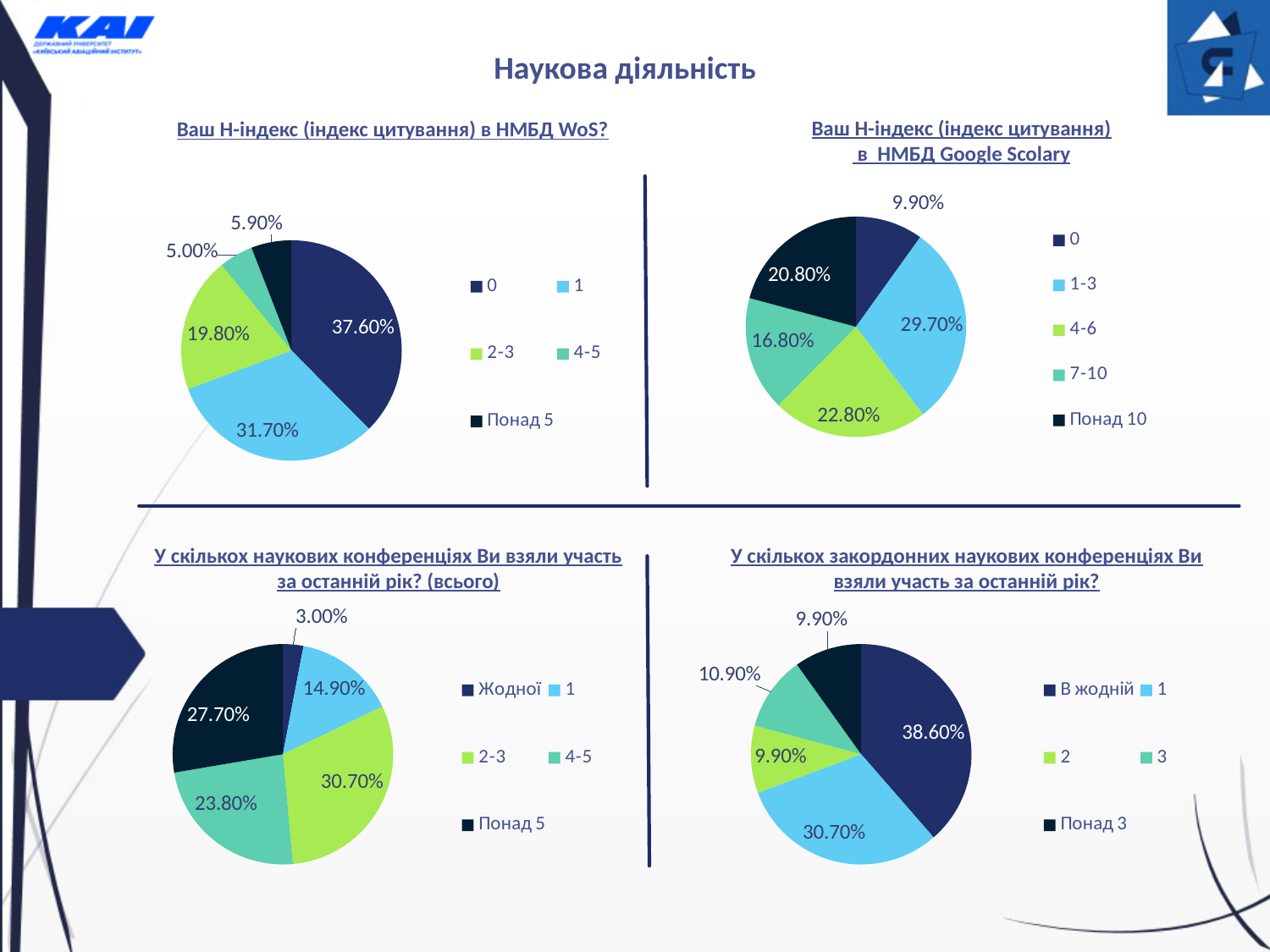
In the chart 'Ваш Н-індекс (індекс цитування) в НМБД Google Scolary', how many categories does the legend list? 5 In the chart 'Ваш Н-індекс (індекс цитування) в НМБД WoS?', what is the difference between the shares for '0' and '1'? 5.90% In the chart 'Ваш Н-індекс (індекс цитування) в НМБД WoS?', which category has the smallest share? 4-5 In the chart 'Ваш Н-індекс (індекс цитування) в НМБД WoS?', what share of respondents have an H-index of 0? 37.60% In the chart 'Ваш Н-індекс (індекс цитування) в НМБД Google Scolary', what share corresponds to the category '1-3'? 29.70% In the chart 'У скількох закордонних наукових конференціях Ви взяли участь за останній рік?', what is the share for the category '3'? 10.90% In the chart 'У скількох наукових конференціях Ви взяли участь за останній рік? (всього)', what share of respondents answered 'Жодної'? 3.00% How many pie charts are shown on the slide? 4 In the chart 'У скількох закордонних наукових конференціях Ви взяли участь за останній рік?', what share of respondents answered 'В жодній'? 38.60% In the chart 'Ваш Н-індекс (індекс цитування) в НМБД Google Scolary', which category has the largest share? 1-3 In the chart 'У скількох наукових конференціях Ви взяли участь за останній рік? (всього)', which is larger: the share for '4-5' or for 'Понад 5'? Понад 5 What type of chart is used for 'У скількох закордонних наукових конференціях Ви взяли участь за останній рік?'? Pie chart